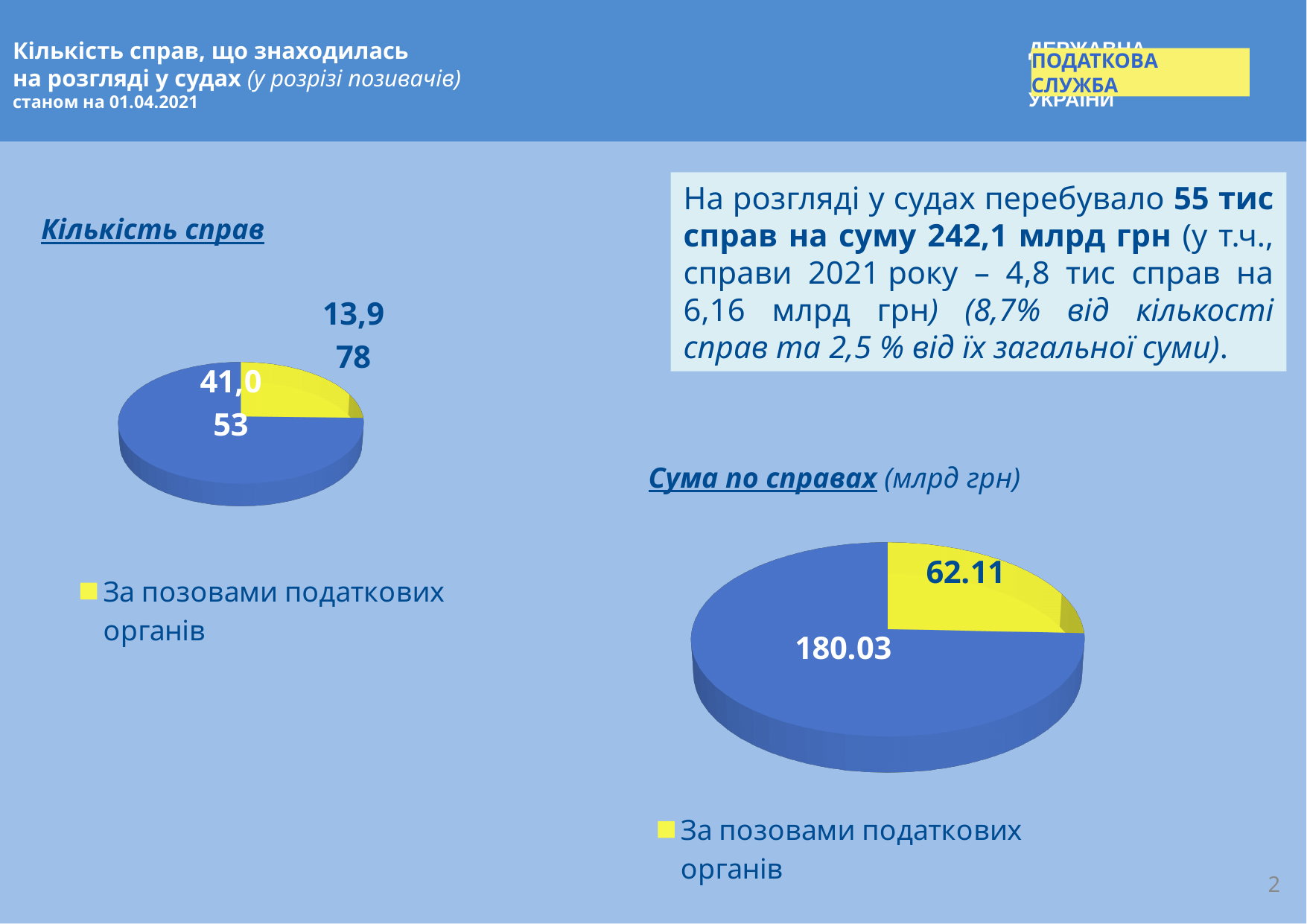
What legend entry is shown below the chart titled "Сума по справах (млрд грн)"? За позовами податкових органів In the chart titled "Сума по справах (млрд грн)", what is the value for "За позовами податкових органів"? 62.11 In the chart titled "Сума по справах (млрд грн)", what is the total of the two slices? 242.14 What kind of chart is the chart titled "Кількість справ"? pie chart In the chart titled "Сума по справах (млрд грн)", what is the difference between the blue slice (180.03) and the yellow slice (62.11)? 117.92 In the chart titled "Кількість справ", which slice is larger, the blue one or the yellow one? the blue one In the chart titled "Сума по справах (млрд грн)", which slice is larger, the blue one or the yellow one? the blue one How many slices does the chart titled "Сума по справах (млрд грн)" have? 2 In the chart titled "Кількість справ", what value is shown on the blue slice? 41,053 In the chart titled "Кількість справ", what is the value for "За позовами податкових органів"? 13,978 How many entries does the legend of the chart titled "Кількість справ" list? 1 In the chart titled "Сума по справах (млрд грн)", what value is shown on the blue slice? 180.03